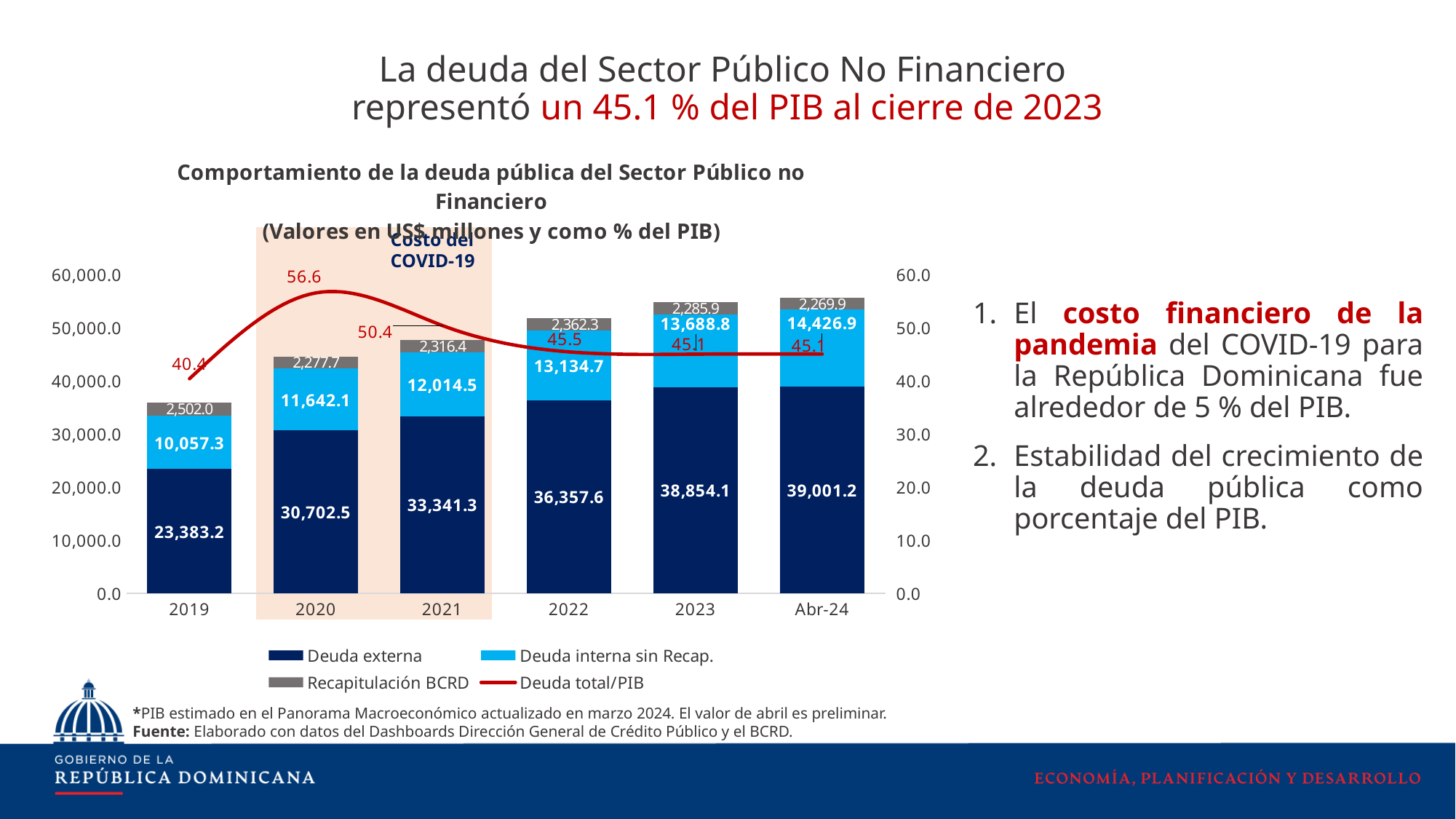
Which category has the lowest Deuda externa value? 2019 What is the value of Deuda externa for 2021? 33,341.3 How many categories are shown on the x axis? 6 What is the Deuda total/PIB value for 2020? 56.6 Which is larger: Deuda interna sin Recap. in 2022 or in 2020? 2022 In which year does the Deuda total/PIB line reach its highest value? 2020 What is the Recapitulación BCRD value for 2019? 2,502.0 What is the value of Deuda interna sin Recap. for Abr-24? 14,426.9 How many series does the legend list? 4 What is the total of the stacked bar for 2019? 35,942.5 What is the difference between Deuda externa in 2023 and in 2019? 15,470.9 Does the Deuda externa series rise or fall from 2019 to Abr-24? rise